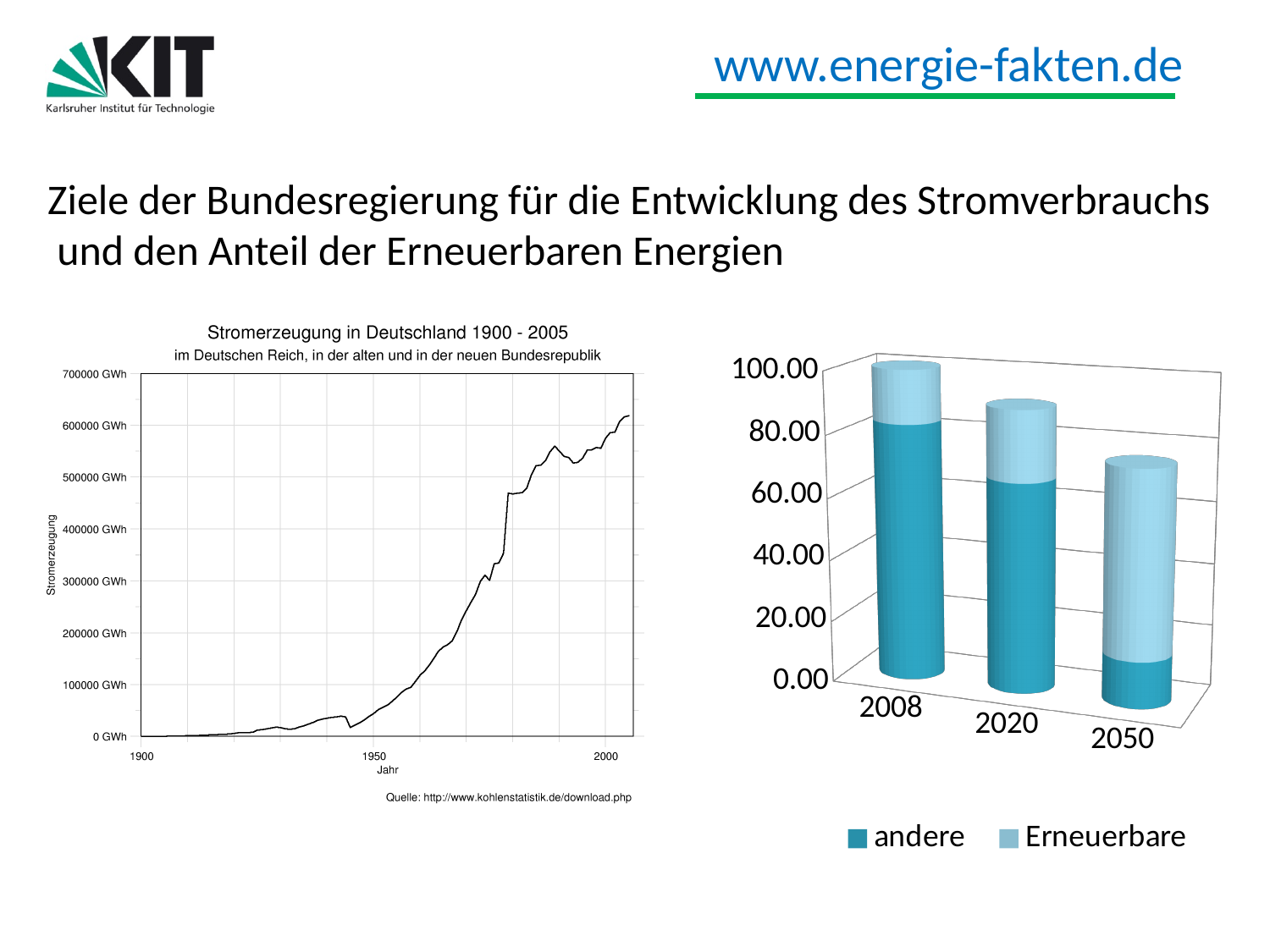
In the chart on the left of the slide, does electricity generation (Stromerzeugung) generally rise or fall from 1900 to 2005? rise In the chart on the right of the slide, how many series does the legend list? 2 What is the title of the chart on the left of the slide? Stromerzeugung in Deutschland 1900 - 2005 In the chart on the right of the slide, how many categories are shown on the x axis? 3 In the chart on the right of the slide, is the "andere" value for 2008 greater or less than 60.00? greater In the chart on the right of the slide, which category has the smallest "andere" segment? 2050 In the chart on the right of the slide, is the "Erneuerbare" segment larger for 2050 or for 2008? 2050 In the chart on the right of the slide, is the "andere" value for 2050 greater or less than 20.00? less What kind of chart is the chart on the left of the slide, titled "Stromerzeugung in Deutschland 1900 - 2005"? line chart In the chart on the right of the slide, which series is shown in the darker blue colour? andere What kind of chart is the chart on the right of the slide, with categories 2008, 2020 and 2050? stacked bar chart In the chart on the right of the slide, which category has the largest "andere" segment? 2008